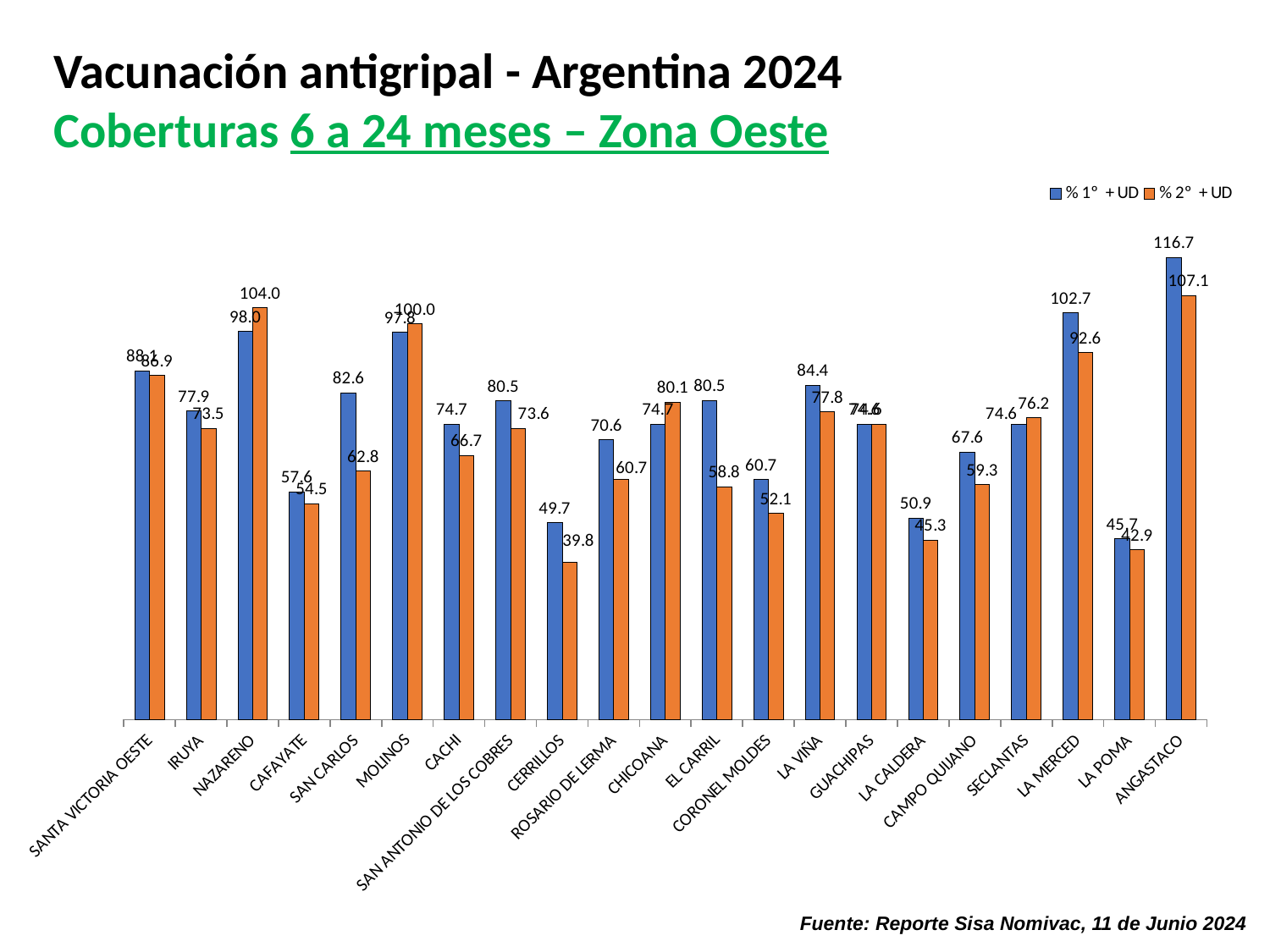
What is the % 2° + UD value for NAZARENO? 104.0 What is the difference between the % 1° + UD values of ANGASTACO and LA POMA? 71.0 Which colour represents the % 2° + UD series? Orange What is the % 2° + UD value for CERRILLOS? 39.8 What kind of chart is shown on the slide? Bar chart Which locality has the highest % 1° + UD value? ANGASTACO What is the % 1° + UD value for LA MERCED? 102.7 How many series does the legend list? 2 How many localities are shown on the x axis? 21 Which is larger for MOLINOS, the % 1° + UD value or the % 2° + UD value? % 2° + UD Which locality has the lowest % 2° + UD value? CERRILLOS What is the difference between the % 1° + UD and % 2° + UD values for SAN CARLOS? 19.8